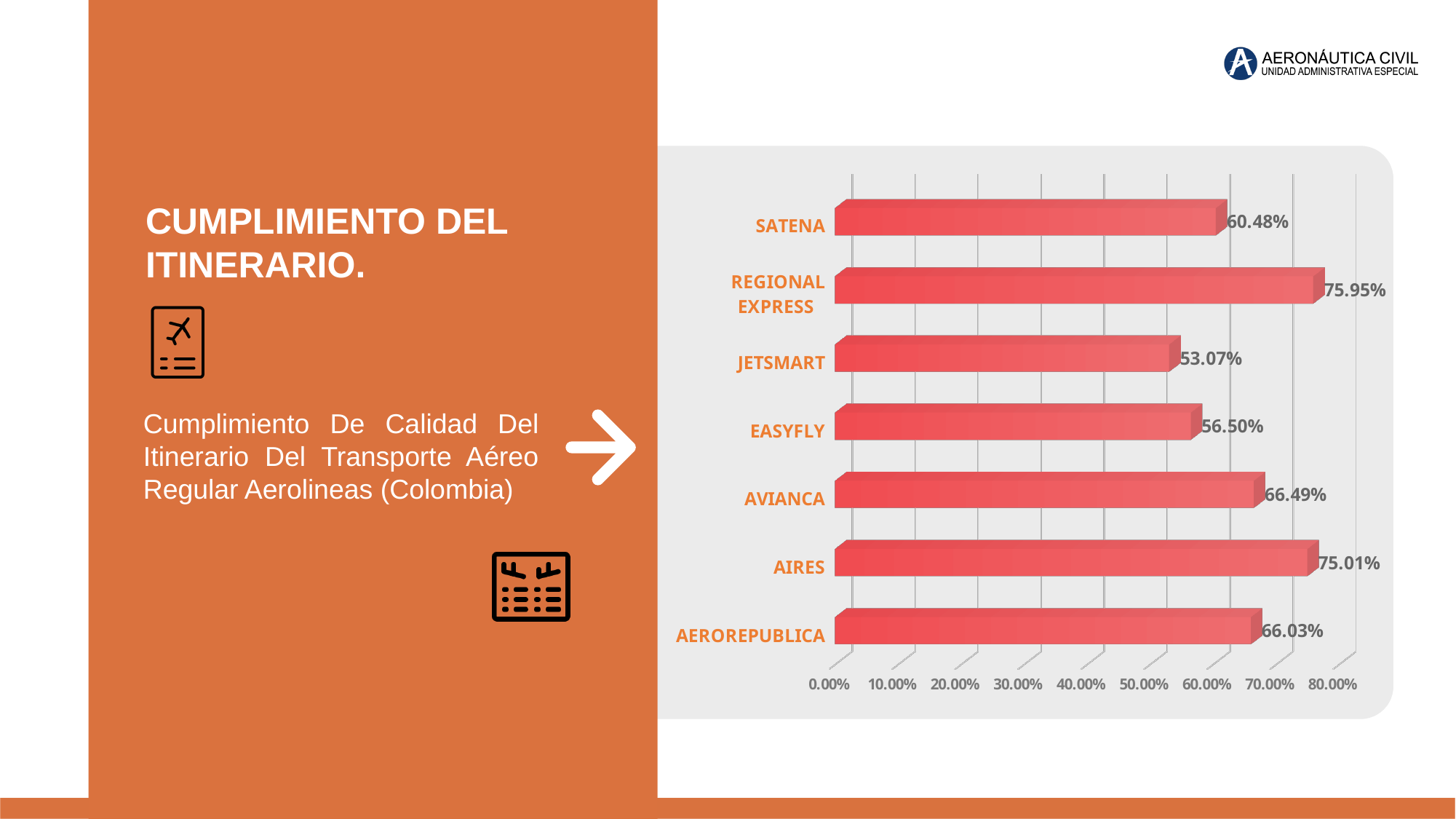
What is the highest value shown on the x axis? 80.00% What is the value for JETSMART? 53.07% What is the value for SATENA? 60.48% Is the value for AIRES greater or less than 70.00%? greater How many airlines are shown in the chart? 7 Which airline has the lowest value? JETSMART Which is larger, the value for EASYFLY or the value for SATENA? SATENA What is the value for AIRES? 75.01% Which airline has the highest value? REGIONAL EXPRESS What kind of chart is shown on the slide? bar chart What is the difference between the values for REGIONAL EXPRESS and JETSMART? 22.88% What is the difference between the values for AVIANCA and AEROREPUBLICA? 0.46%